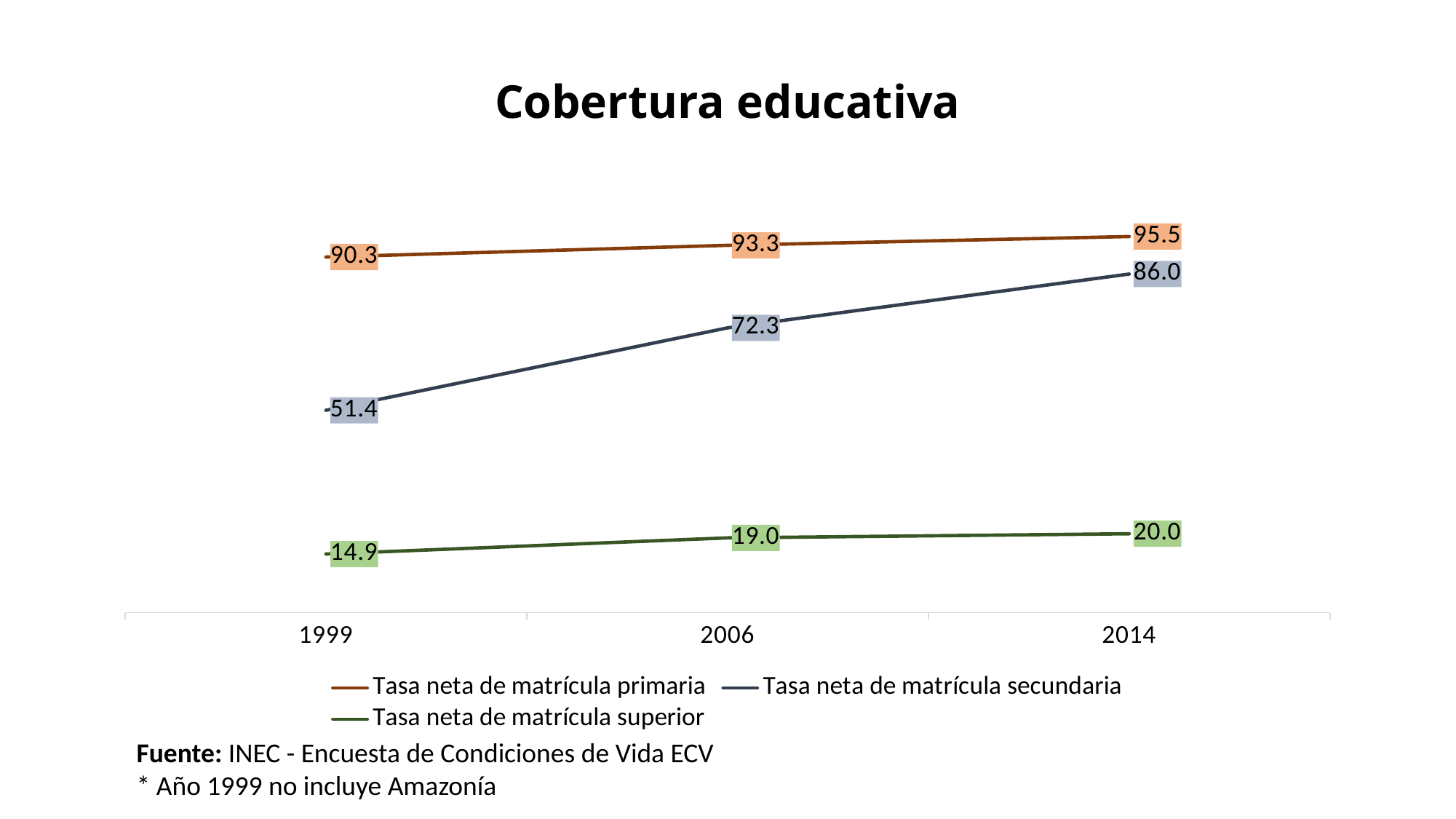
How many years are shown on the x axis? 3 What is the difference between Tasa neta de matrícula primaria and Tasa neta de matrícula secundaria in 2006? 21.0 Which is larger in 2014: Tasa neta de matrícula primaria or Tasa neta de matrícula secundaria? Tasa neta de matrícula primaria In which year is Tasa neta de matrícula superior lowest? 1999 What is the value of Tasa neta de matrícula superior in 2014? 20.0 How many series does the legend list? 3 What is the value of Tasa neta de matrícula primaria in 1999? 90.3 What is the value of Tasa neta de matrícula secundaria in 2006? 72.3 Does Tasa neta de matrícula secundaria rise or fall from 1999 to 2014? Rise In which year is Tasa neta de matrícula secundaria highest? 2014 What kind of chart is this? Line chart What is the difference between Tasa neta de matrícula secundaria in 2014 and in 1999? 34.6